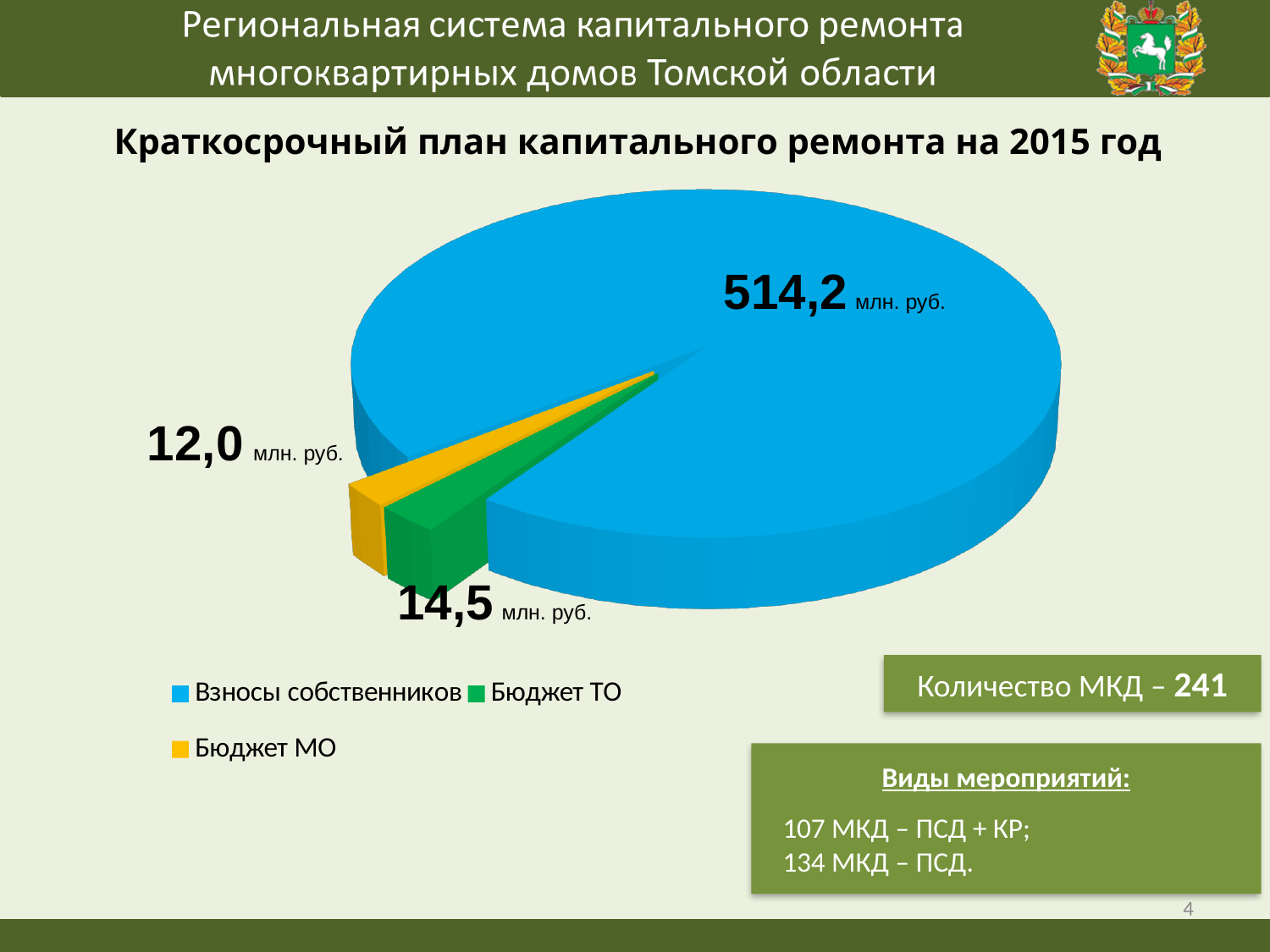
What type of chart is shown on the slide? Pie chart How many slices does the pie chart have? 3 Which category has the smallest slice of the pie? Бюджет МО What is the value for Бюджет МО? 12,0 млн. руб. What is the difference between Взносы собственников and Бюджет ТО? 499,7 млн. руб. Which is larger, Бюджет ТО or Бюджет МО? Бюджет ТО Which category has the largest slice of the pie? Взносы собственников Which colour represents Бюджет МО in the legend? Yellow What is the value for Взносы собственников? 514,2 млн. руб. What is the difference between Бюджет ТО and Бюджет МО? 2,5 млн. руб. What is the value for Бюджет ТО? 14,5 млн. руб. What is the total of all three slices of the pie? 540,7 млн. руб.